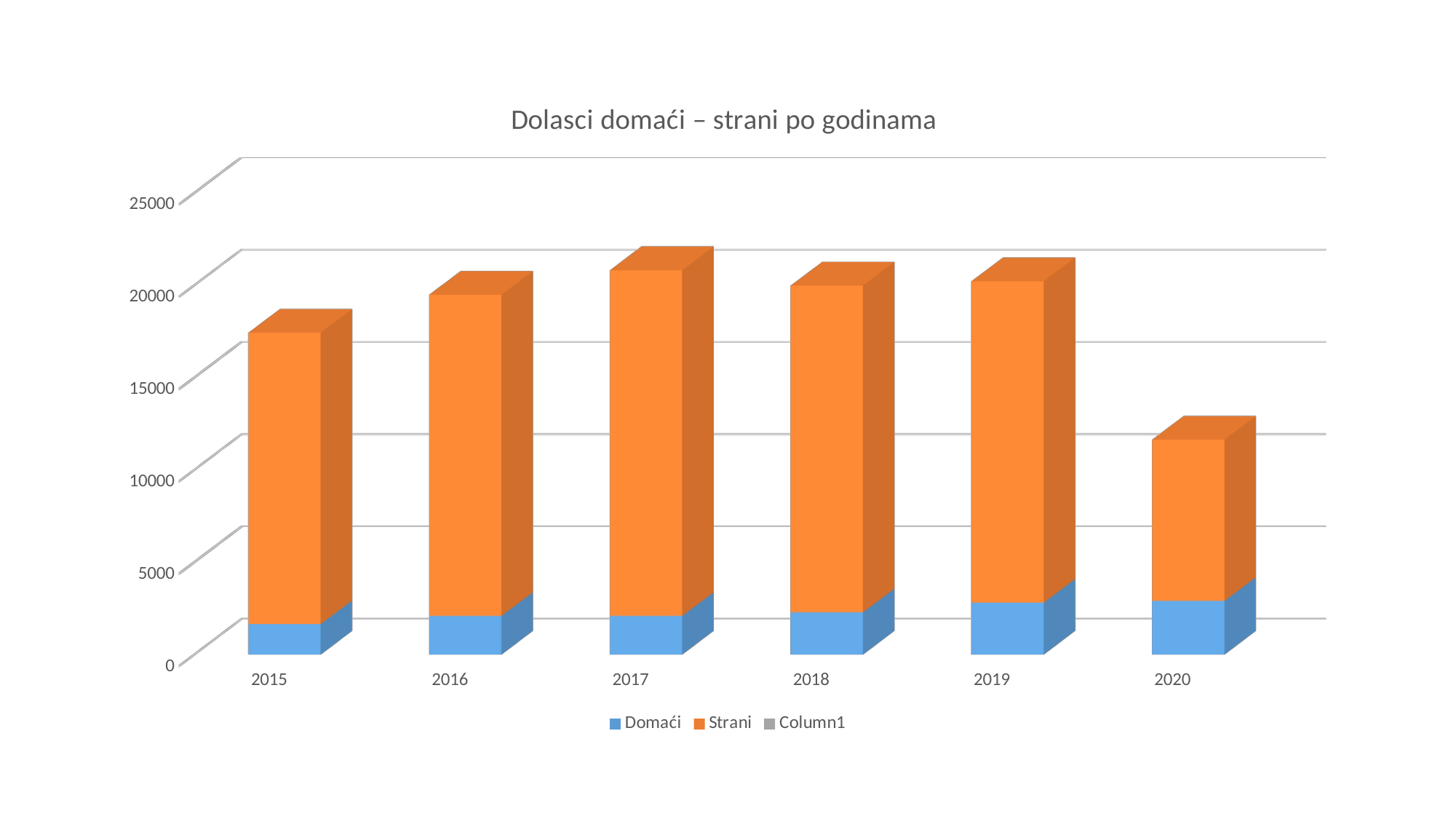
Does the total bar rise or fall from 2019 to 2020? fall Which year has the lowest total bar in the chart? 2020 Which year has the highest total bar in the chart? 2017 How many series does the chart legend list? 3 Is the total bar for 2020 greater or less than 15000? less How many years are shown on the x axis of the chart? 6 What kind of chart is shown on the slide? Stacked bar chart Which year has the larger total bar, 2015 or 2016? 2016 What is the title of the chart? Dolasci domaći – strani po godinama Which series is shown in orange in the chart? Strani Which year has the larger Domaći value, 2015 or 2020? 2020 Is the total bar for 2015 greater or less than 15000? greater